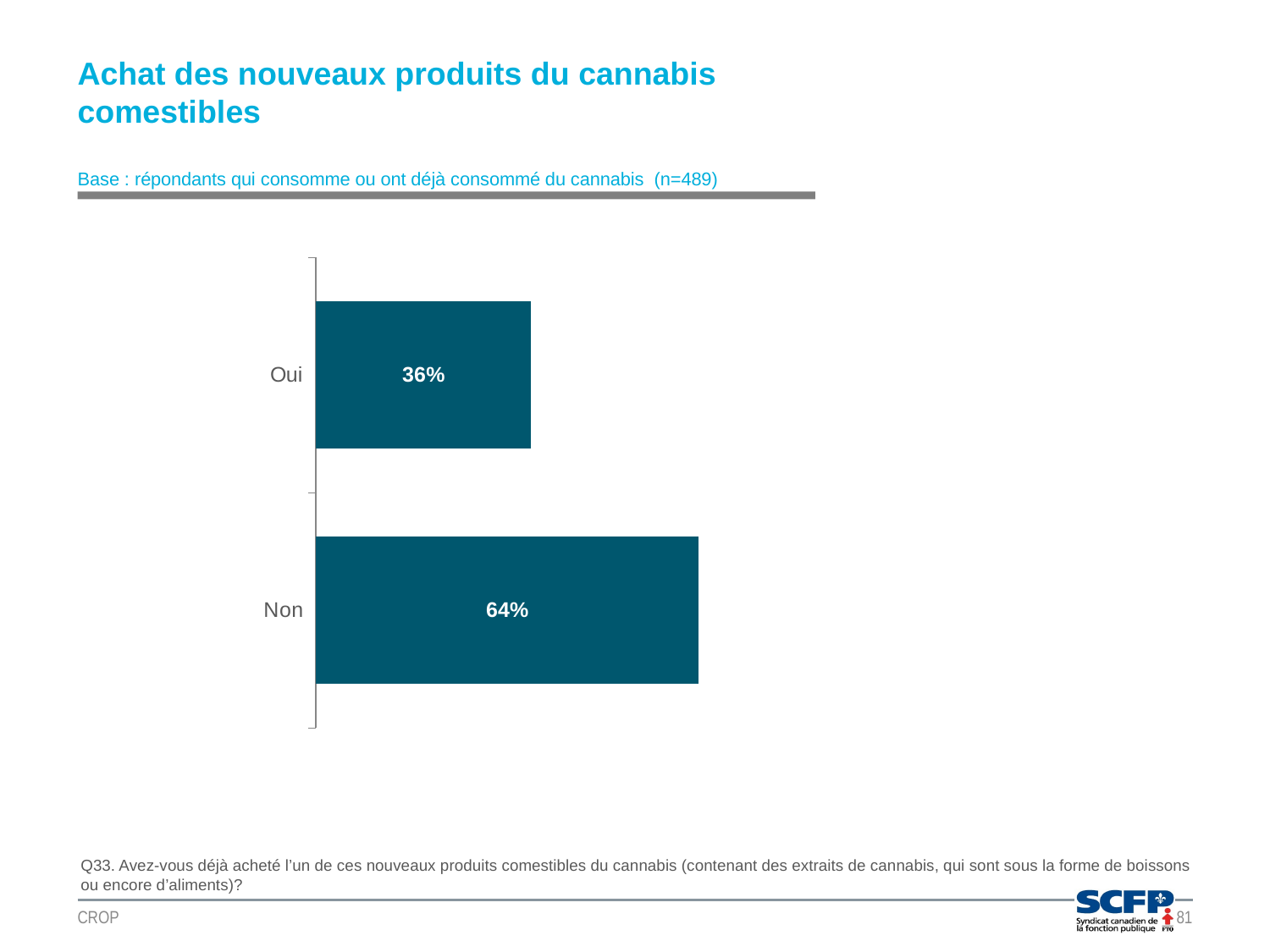
What kind of chart is shown on the slide? Bar chart What is the value for "Oui"? 36% Which category has the lowest value? Oui What is the title of the slide? Achat des nouveaux produits du cannabis comestibles How many categories are shown in the chart? 2 What is the difference between the values for "Non" and "Oui"? 28% Which category has the highest value? Non What is the base size (n) stated for the chart? n=489 Which is larger, the value for "Oui" or the value for "Non"? Non What is the value for "Non"? 64% What is the total of the two values shown in the chart? 100%